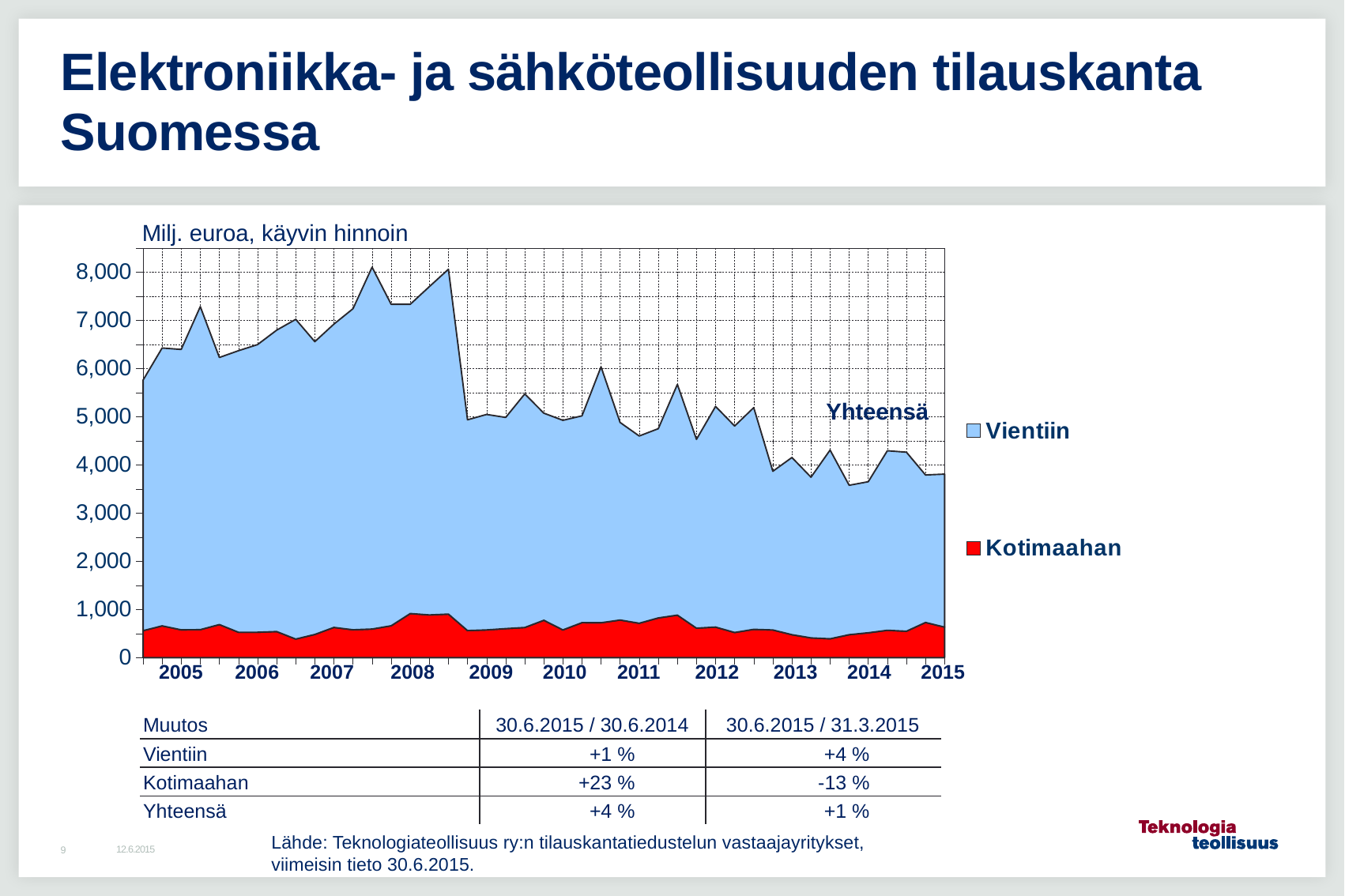
How many years are labelled on the x axis of the chart? 11 Does the total (Yhteensä) value generally rise or fall from 2008 to 2015? fall Is the total (Yhteensä) value higher in 2007 or in 2013? 2007 Is the total (Yhteensä) value at the start of 2005 greater or less than 5,000? greater What kind of chart is shown on the slide? Stacked area chart Which series is larger throughout the chart, Vientiin or Kotimaahan? Vientiin Is the total (Yhteensä) value at the end of the series in 2015 greater or less than 4,000? less Which two series are listed in the chart legend? Vientiin and Kotimaahan What unit is stated above the chart's y axis? Milj. euroa, käyvin hinnoin How many series does the chart legend list? 2 Is the total (Yhteensä) value at the start of 2009 greater or less than 6,000? less